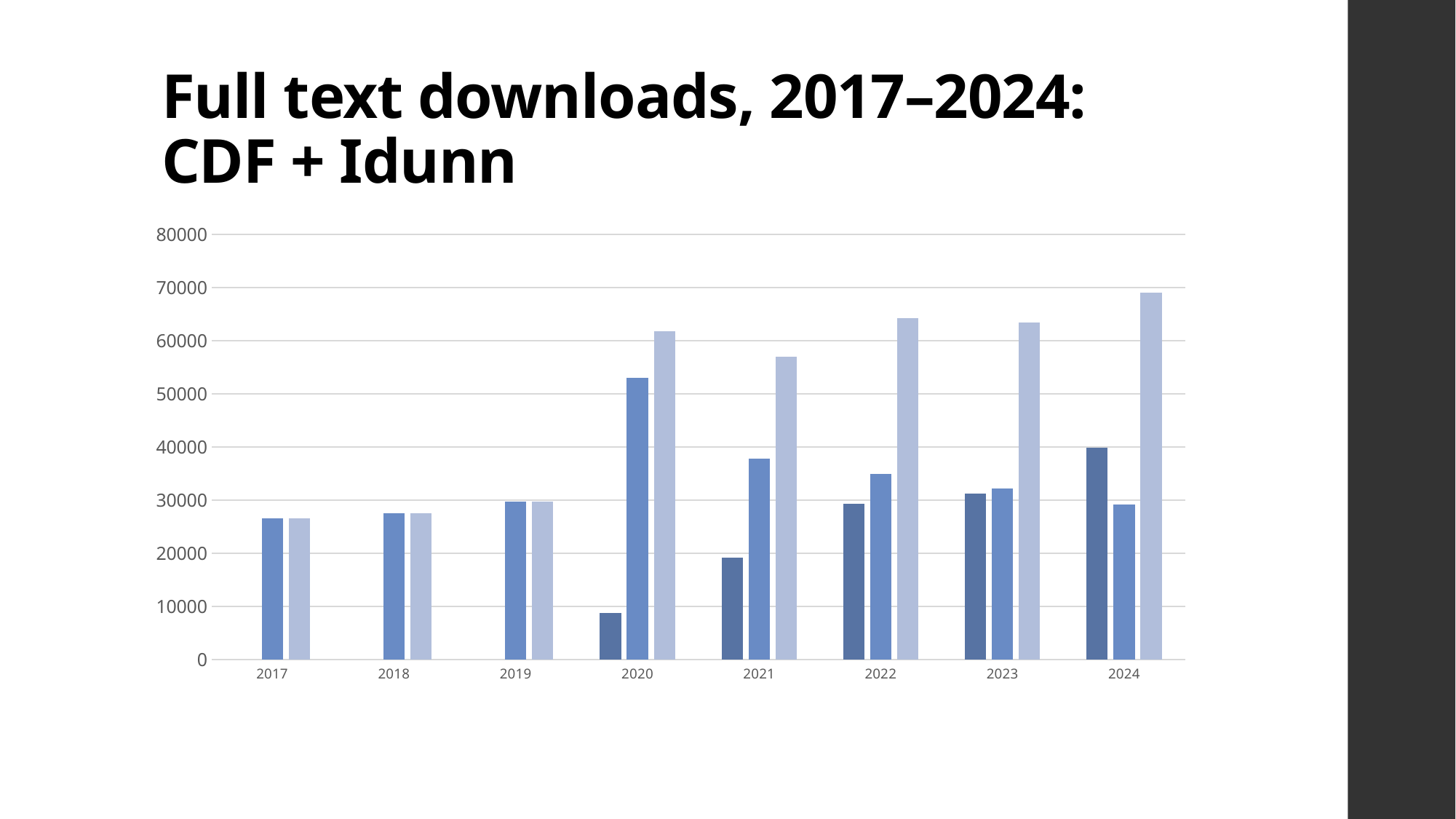
How many bars are plotted for the year 2024? 3 Is the value of the darkest blue bar for 2020 greater or less than 10000? less What is the title of the chart on the slide? Full text downloads, 2017–2024: CDF + Idunn How many bars are plotted for the year 2017? 2 What kind of chart is shown on the slide? Bar chart Which is larger in 2024: the darkest blue bar or the medium blue bar? The darkest blue bar Is the value of the lightest blue bar for 2017 greater or less than 30000? less How many years are shown along the x axis of the chart? 8 Is the value of the medium blue bar for 2021 greater or less than 30000? greater In which year does the lightest blue bar reach its highest value? 2024 Do the lightest blue bars rise or fall from 2017 to 2020? Rise